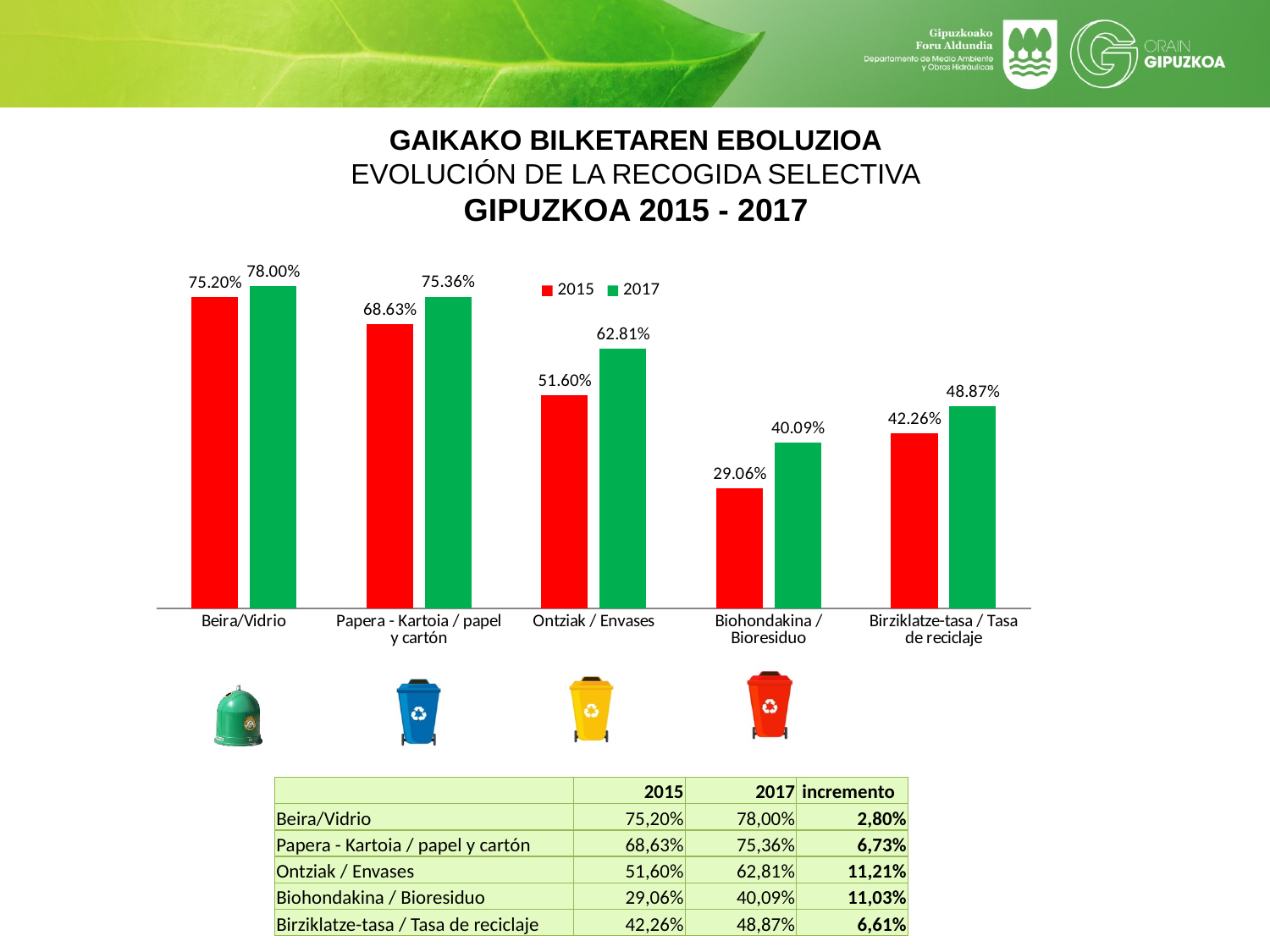
What is the 2017 value for Biohondakina / Bioresiduo? 40.09% How many series does the legend list? 2 What is the 2017 value for Ontziak / Envases? 62.81% What is the difference between the 2017 and 2015 values for Ontziak / Envases? 11.21% What kind of chart is shown on the slide? Bar chart Which category has the lowest 2015 value? Biohondakina / Bioresiduo How many categories are shown on the x axis? 5 What is the 2015 value for Beira/Vidrio? 75.20% Which is larger: the 2015 value for Papera - Kartoia / papel y cartón or the 2017 value for Ontziak / Envases? 2015 value for Papera - Kartoia / papel y cartón Which category has the highest 2017 value? Beira/Vidrio What is the difference between the 2017 and 2015 values for Papera - Kartoia / papel y cartón? 6.73% What is the 2015 value for Birziklatze-tasa / Tasa de reciclaje? 42.26%